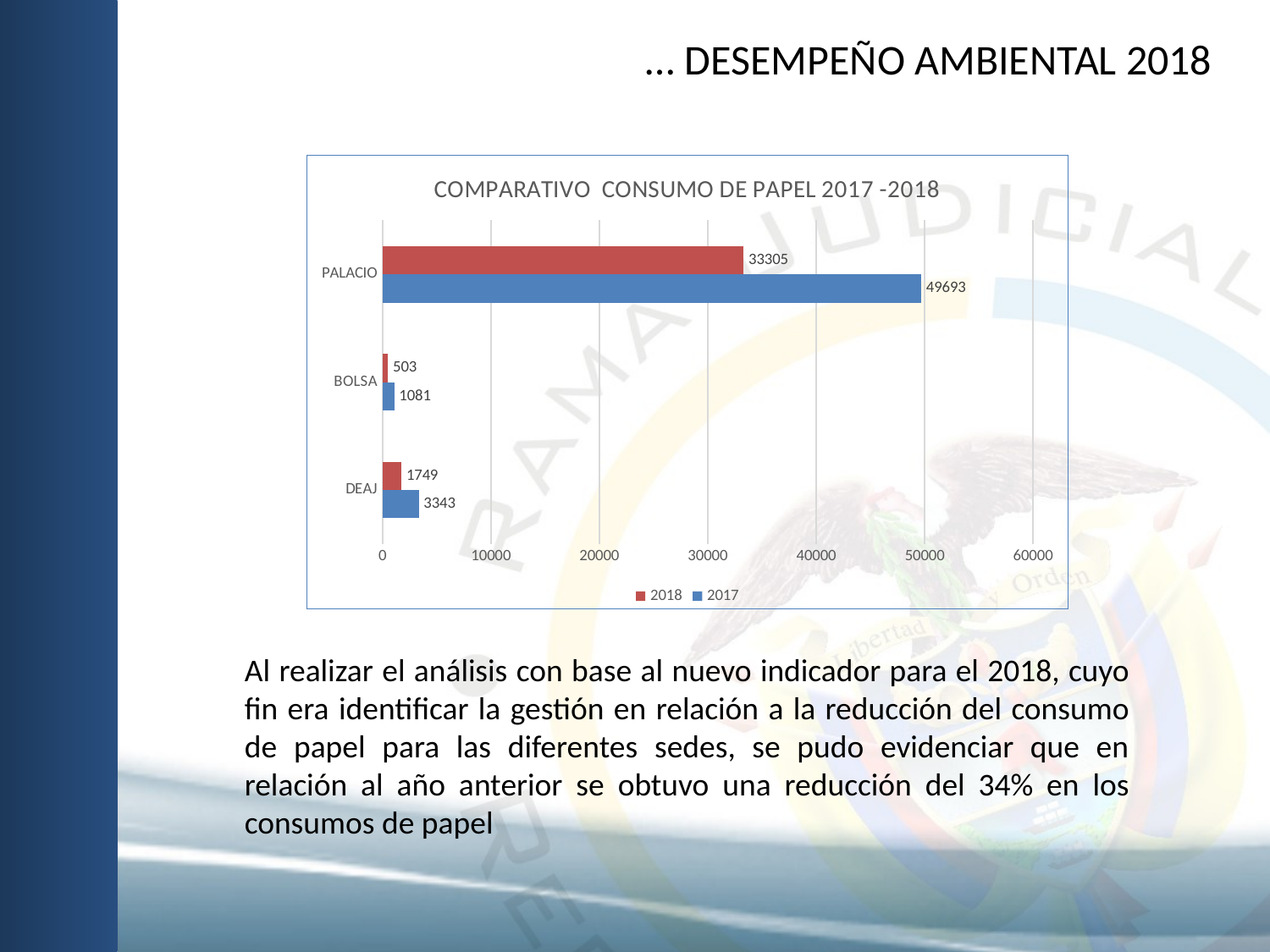
What is the 2018 paper consumption value for BOLSA? 503 What kind of chart is shown on the slide? bar chart What is the title of the chart? COMPARATIVO CONSUMO DE PAPEL 2017 -2018 What is the difference between the 2017 and 2018 values for PALACIO? 16388 How many categories are shown on the chart? 3 Which is larger for DEAJ, the 2017 value or the 2018 value? 2017 How many series does the legend list? 2 Is the 2018 value for PALACIO greater or less than 40000? less What is the 2017 paper consumption value for PALACIO? 49693 Which category has the lowest 2017 value? BOLSA Which category has the highest 2018 value? PALACIO What is the 2017 value for DEAJ? 3343